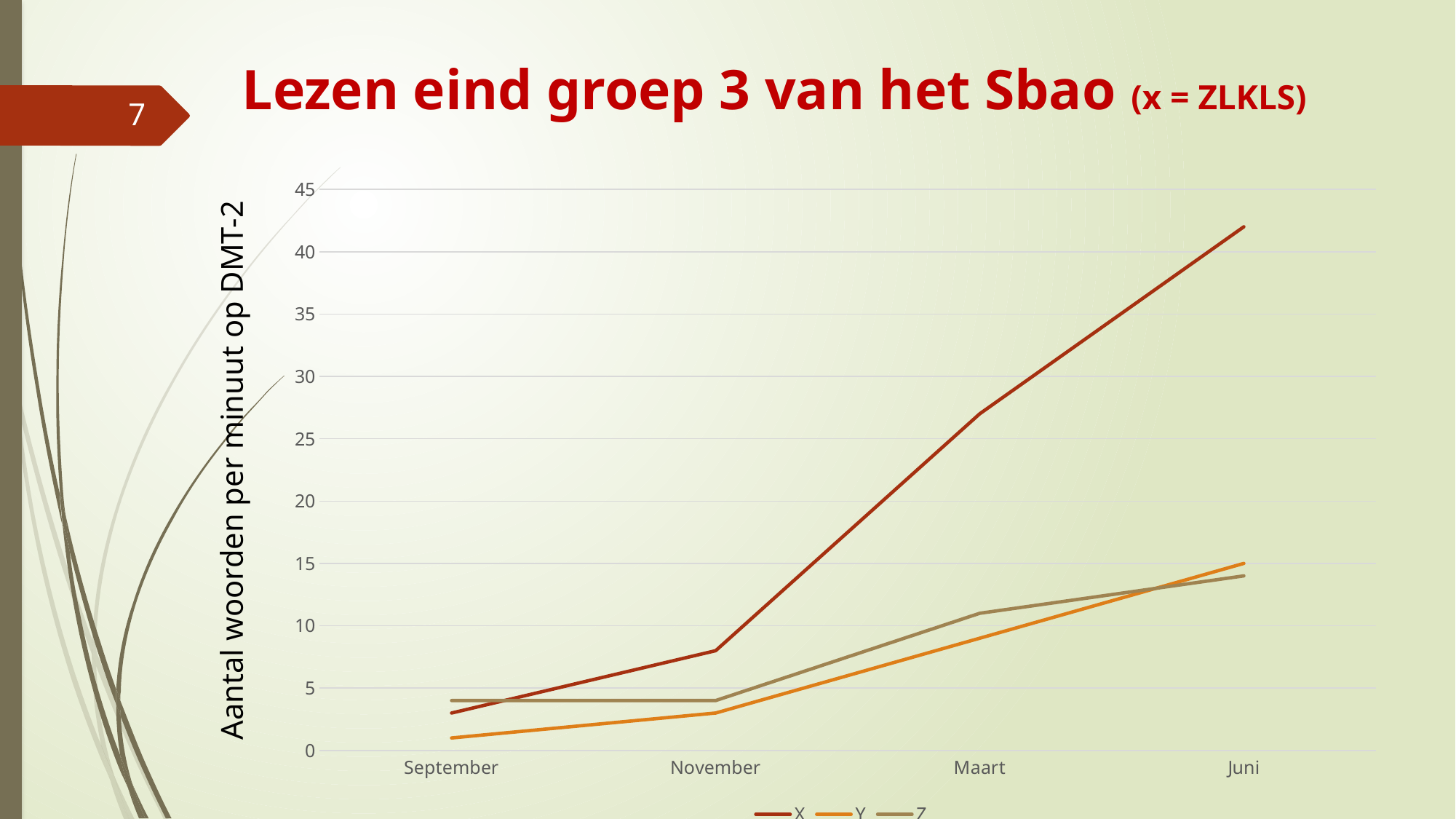
Which series has the lowest value in September? Y How many months are shown on the x axis? 4 Which series has the highest value in Juni? X Is the value for series X in Maart greater or less than 20? greater How many series does the legend list? 3 What is the label on the vertical axis? Aantal woorden per minuut op DMT-2 Does the value for series X rise or fall from September to Juni? rise In Juni, which series has the larger value, X or Y? X Is the value for series Z in November greater or less than 10? less Is the value for series X in Juni greater or less than 35? greater What kind of chart is shown on the slide? line chart